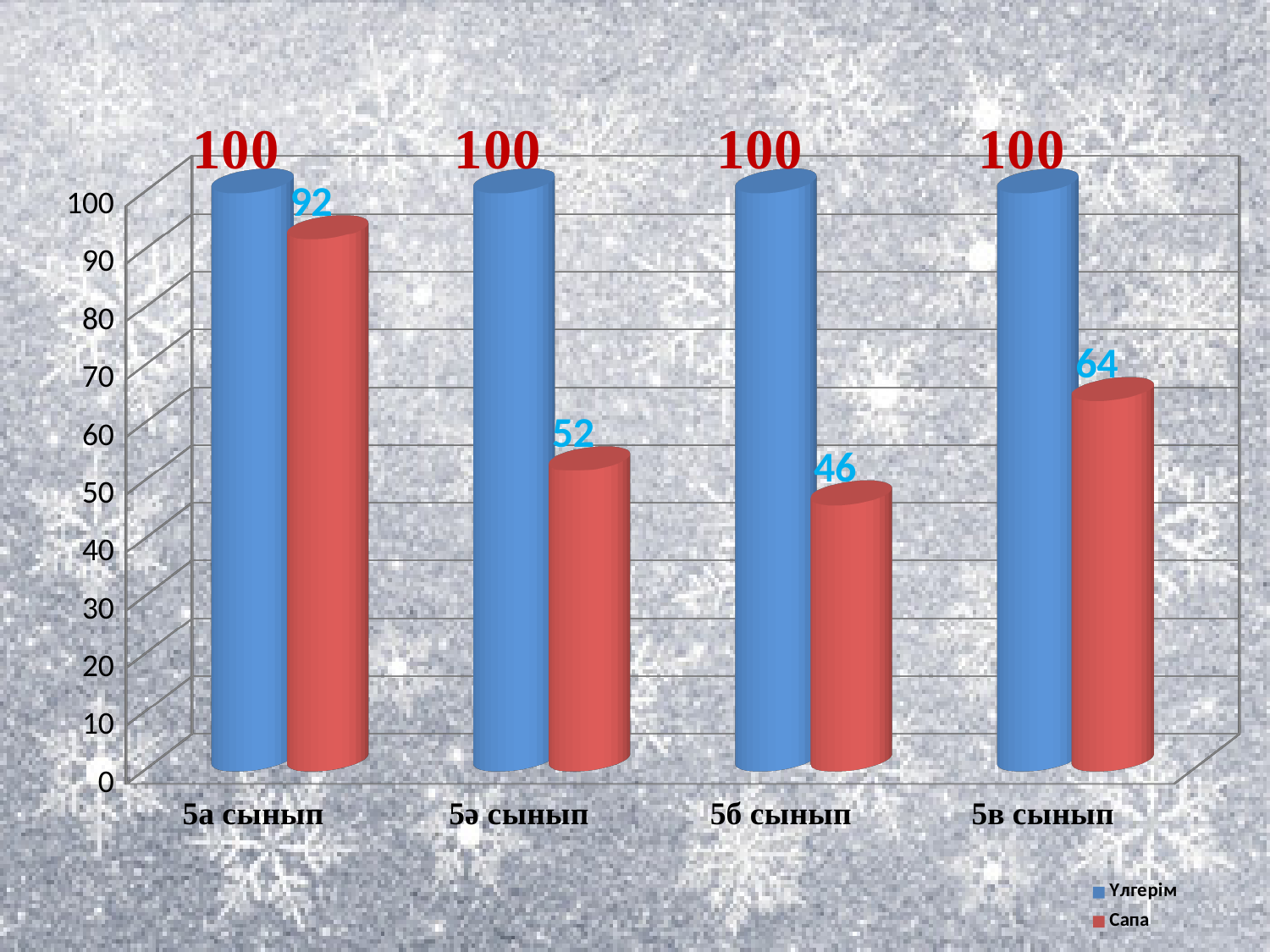
What is the Үлгерім value for 5ә сынып? 100 What is the Сапа value for 5а сынып? 92 What kind of chart is shown on the slide? Bar chart Which class has the highest Сапа value? 5а сынып How many series does the legend list? 2 How many classes are shown on the x axis? 4 What is the Сапа value for 5б сынып? 46 What is the difference between the Үлгерім and Сапа values for 5ә сынып? 48 Which is larger, the Сапа value for 5в сынып or for 5ә сынып? 5в сынып What is the Сапа value for 5в сынып? 64 Which series is shown in red? Сапа Which class has the lowest Сапа value? 5б сынып